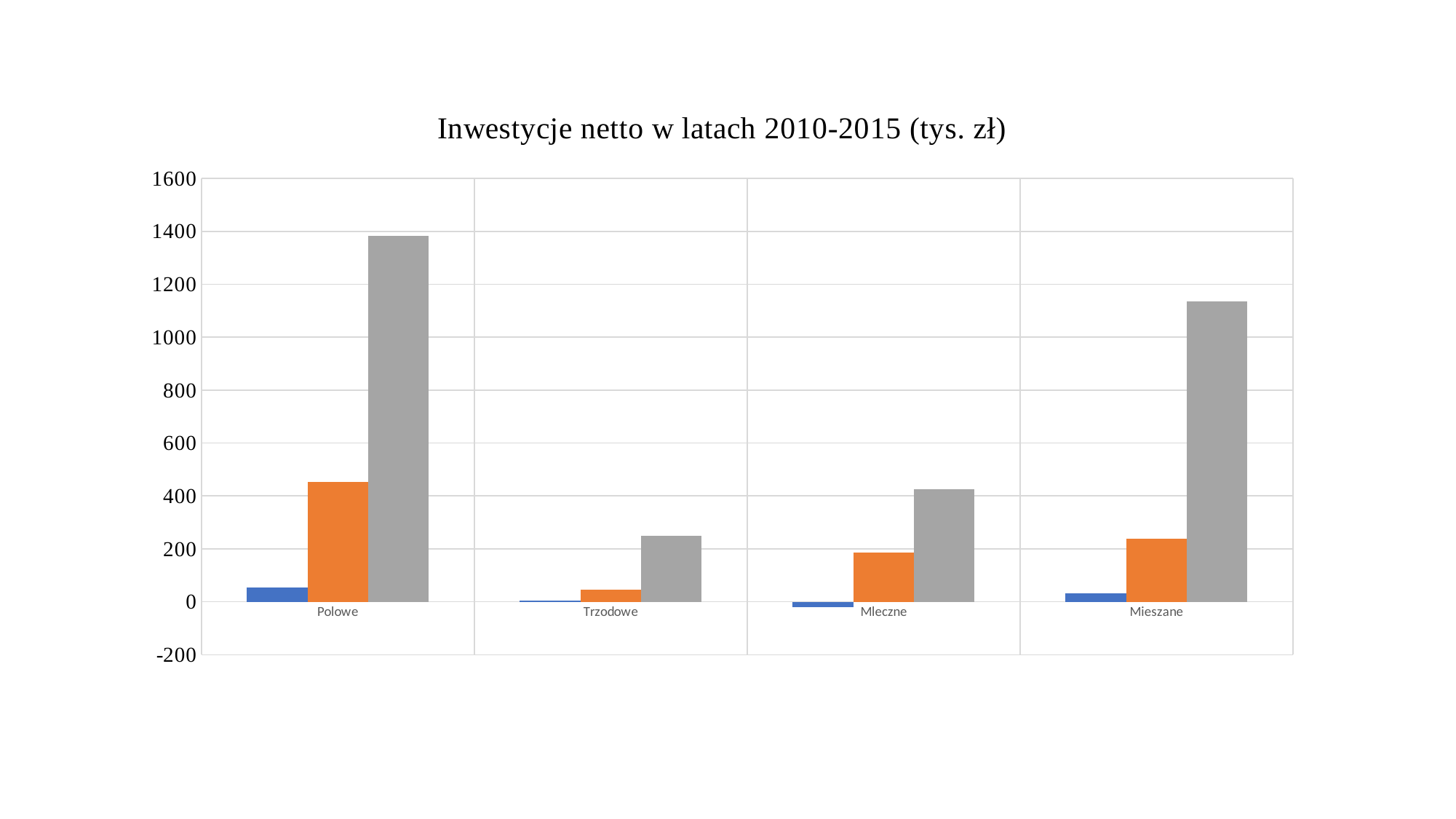
Is the value of the blue bar for Mleczne greater or less than 0? less How many bars are plotted for each category in the chart? 3 Is the orange bar for Mieszane taller or shorter than the orange bar for Polowe? shorter How many categories are shown on the x axis of the chart? 4 Which category has the shortest grey bar? Trzodowe Is the value of the grey bar for Mieszane greater or less than 1000? greater What kind of chart is shown on the slide? bar chart What is the title of the chart? Inwestycje netto w latach 2010-2015 (tys. zł) Which category has the tallest orange bar? Polowe Which category has the tallest grey bar? Polowe Is the value of the grey bar for Polowe greater or less than 1200? greater Is the grey bar for Polowe taller than the grey bar for Mieszane? yes